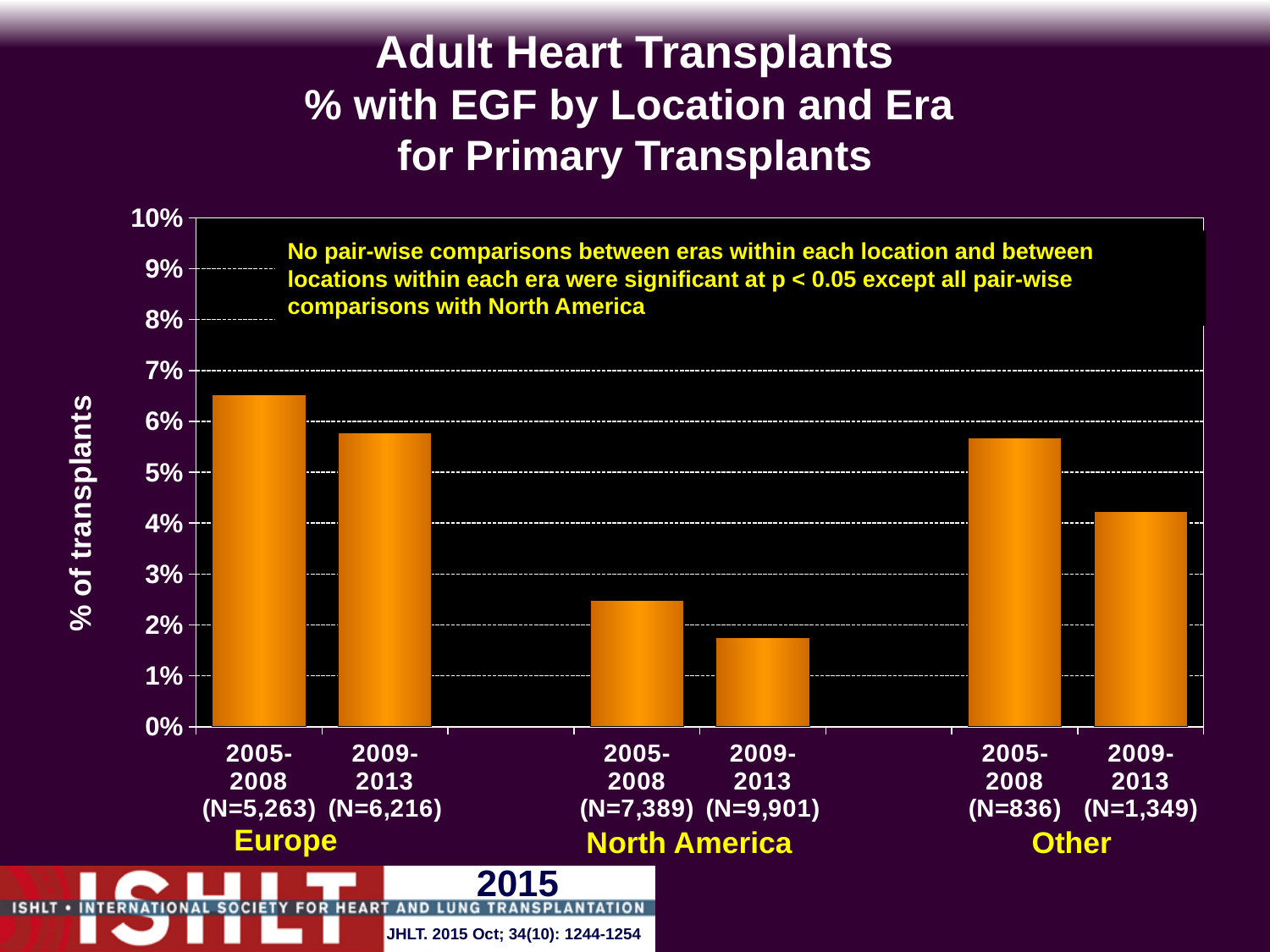
How many bars are plotted in the chart? 6 What kind of chart is shown on the slide? bar chart Within each location, does the % with EGF rise or fall from the 2005-2008 era to the 2009-2013 era? fall Is the value for Europe 2005-2008 greater or less than 6%? greater What is the label on the y axis of the chart? % of transplants Is the value for North America 2009-2013 greater or less than 2%? less Which location and era has the lowest % of transplants with EGF? North America, 2009-2013 Is the value for Other 2009-2013 greater or less than 4%? greater Which is larger, the value for Europe 2009-2013 or the value for Other 2009-2013? Europe 2009-2013 What is the N shown for North America 2009-2013? N=9,901 Which location and era has the highest % of transplants with EGF? Europe, 2005-2008